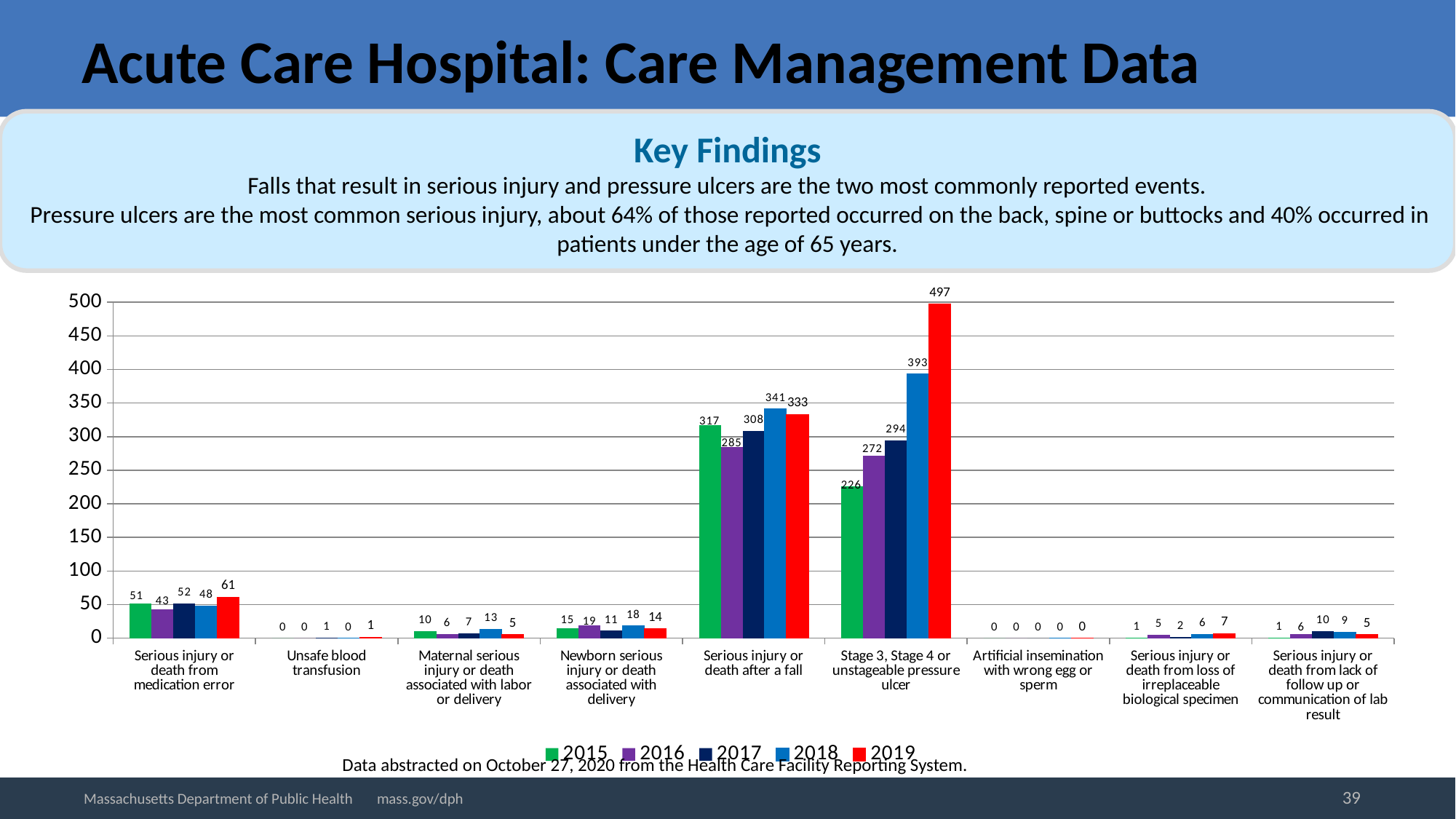
What kind of chart is shown on the slide? bar chart What is the 2019 value for Stage 3, Stage 4 or unstageable pressure ulcer? 497 Which category has the highest value in 2019? Stage 3, Stage 4 or unstageable pressure ulcer What is the 2015 value for Serious injury or death after a fall? 317 Do the values for Stage 3, Stage 4 or unstageable pressure ulcer rise or fall from 2015 to 2019? rise How many categories are shown on the x axis? 9 What is the 2018 value for Serious injury or death from medication error? 48 What is the difference between the 2019 and 2018 values for Stage 3, Stage 4 or unstageable pressure ulcer? 104 Is the 2016 value for Stage 3, Stage 4 or unstageable pressure ulcer greater or less than 250? greater Which is larger for Serious injury or death after a fall: the 2018 value or the 2019 value? 2018 Which category has the lowest values across all years? Artificial insemination with wrong egg or sperm How many series does the legend list? 5